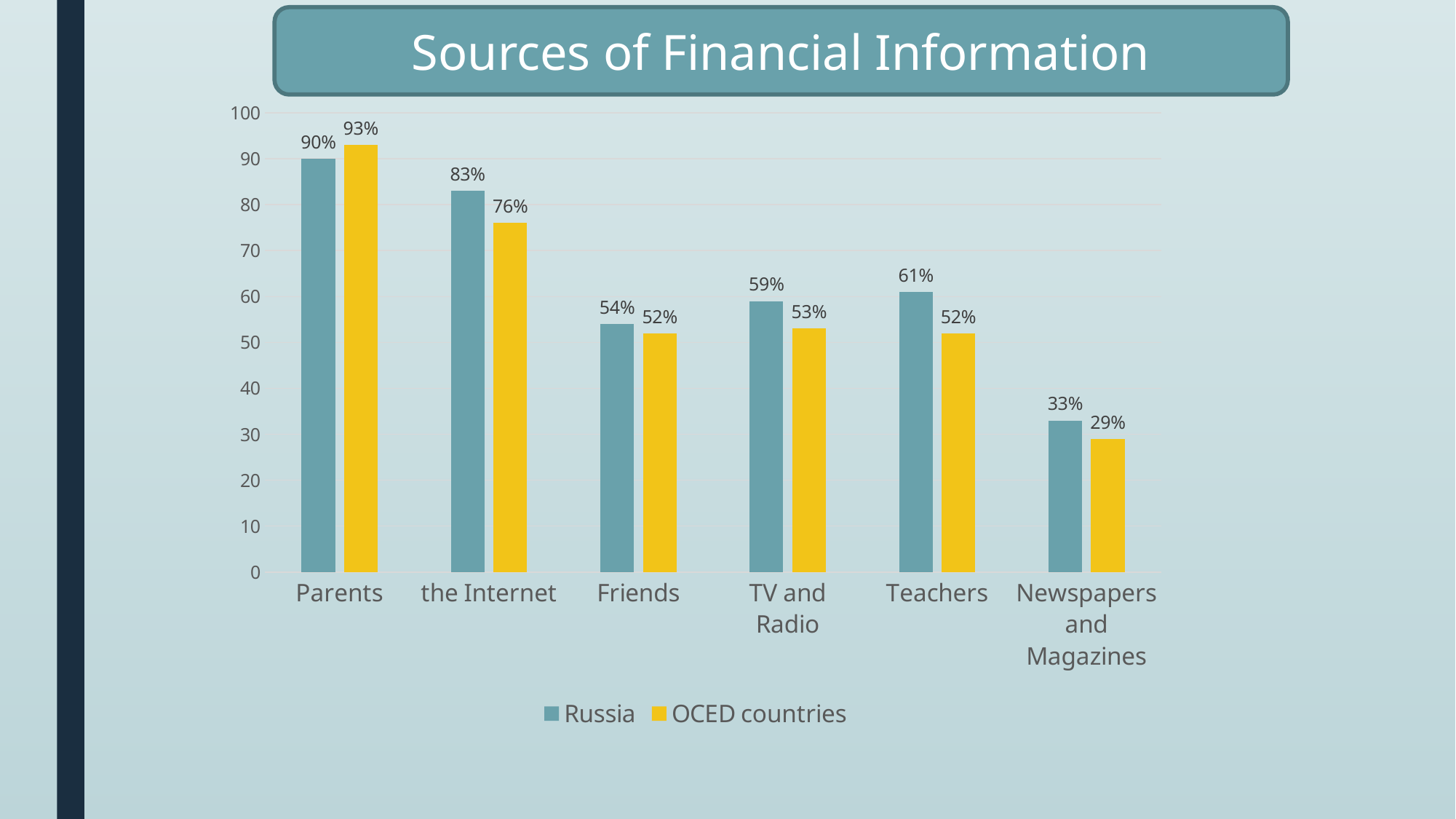
What is the title of the chart? Sources of Financial Information How many categories are shown on the x axis? 6 Which is larger for TV and Radio, the Russia value or the OCED countries value? Russia How many series does the legend list? 2 What kind of chart is shown on the slide? Bar chart What is the value for Russia for Teachers? 61% What is the difference between the Russia and OCED countries values for the Internet? 7% What is the value for Russia for Parents? 90% What is the value for OCED countries for the Internet? 76% Which category has the highest value for OCED countries? Parents What is the value for OCED countries for Newspapers and Magazines? 29% Which category has the lowest value for Russia? Newspapers and Magazines